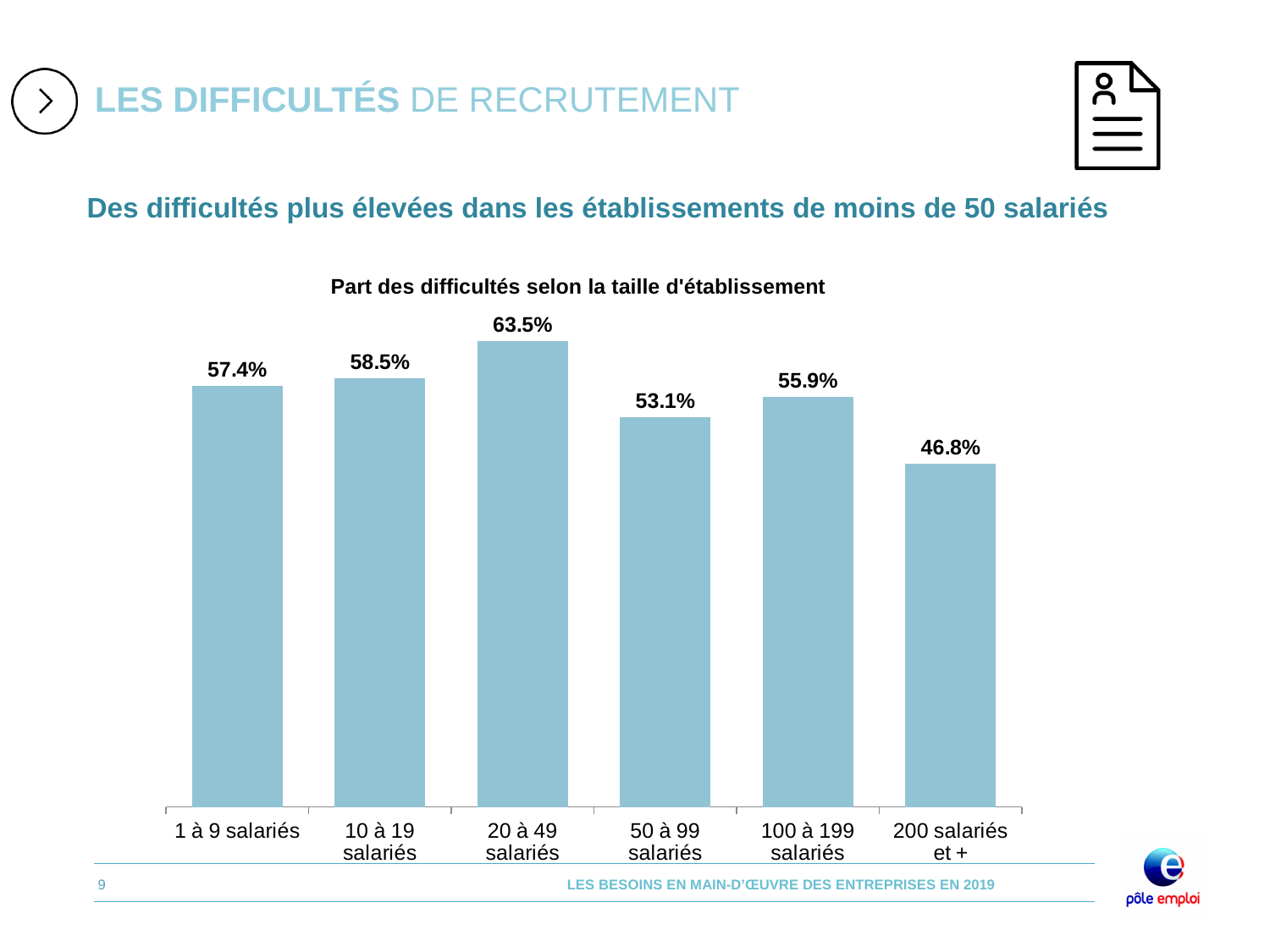
Which is larger, the value for '100 à 199 salariés' or the value for '50 à 99 salariés'? 100 à 199 salariés Do the values rise or fall from '20 à 49 salariés' to '50 à 99 salariés'? Fall What is the difference between the values for '20 à 49 salariés' and '200 salariés et +'? 16.7% How many categories are shown on the chart? 6 What is the value for '20 à 49 salariés'? 63.5% What is the value for '50 à 99 salariés'? 53.1% What is the title of the chart? Part des difficultés selon la taille d'établissement Which category has the lowest value? 200 salariés et + Which category has the highest value? 20 à 49 salariés What is the value for '200 salariés et +'? 46.8% What kind of chart is shown on the slide? Bar chart What is the difference between the values for '10 à 19 salariés' and '1 à 9 salariés'? 1.1%